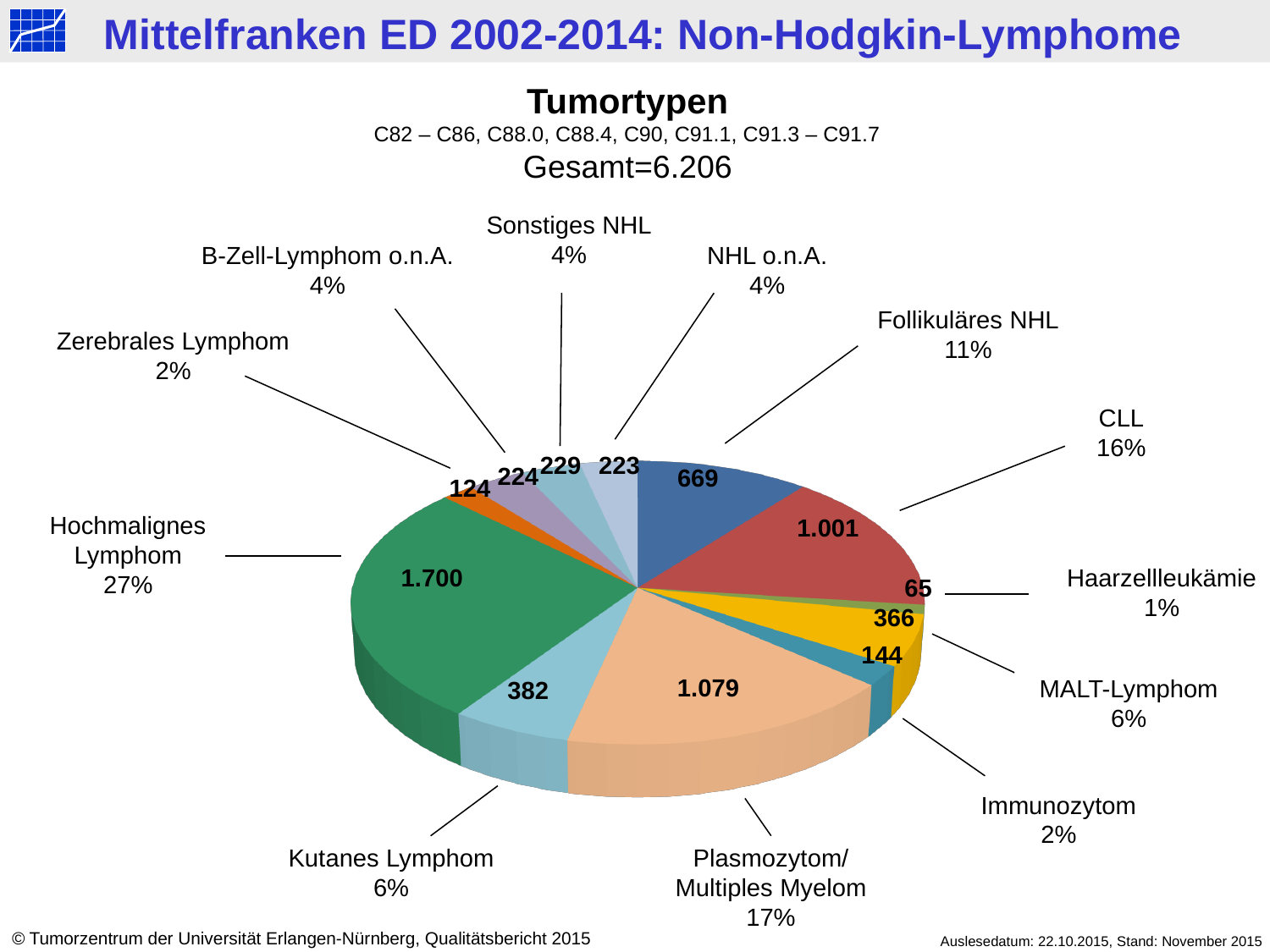
What percentage share does Follikuläres NHL have? 11% What is the value shown for Plasmozytom/Multiples Myelom? 1.079 What is the title of the chart? Tumortypen What is the value shown for Hochmalignes Lymphom? 1.700 How many tumour type categories does the pie chart show? 12 Which tumour type has the largest slice of the pie? Hochmalignes Lymphom Which is larger, the value for Kutanes Lymphom or the value for MALT-Lymphom? Kutanes Lymphom What is the difference between the values for CLL and Follikuläres NHL? 332 What kind of chart is shown on the slide? pie chart Which tumour type has the smallest slice of the pie? Haarzellleukämie What total (Gesamt) is stated for the pie chart? 6.206 What percentage share does CLL have in the pie chart? 16%